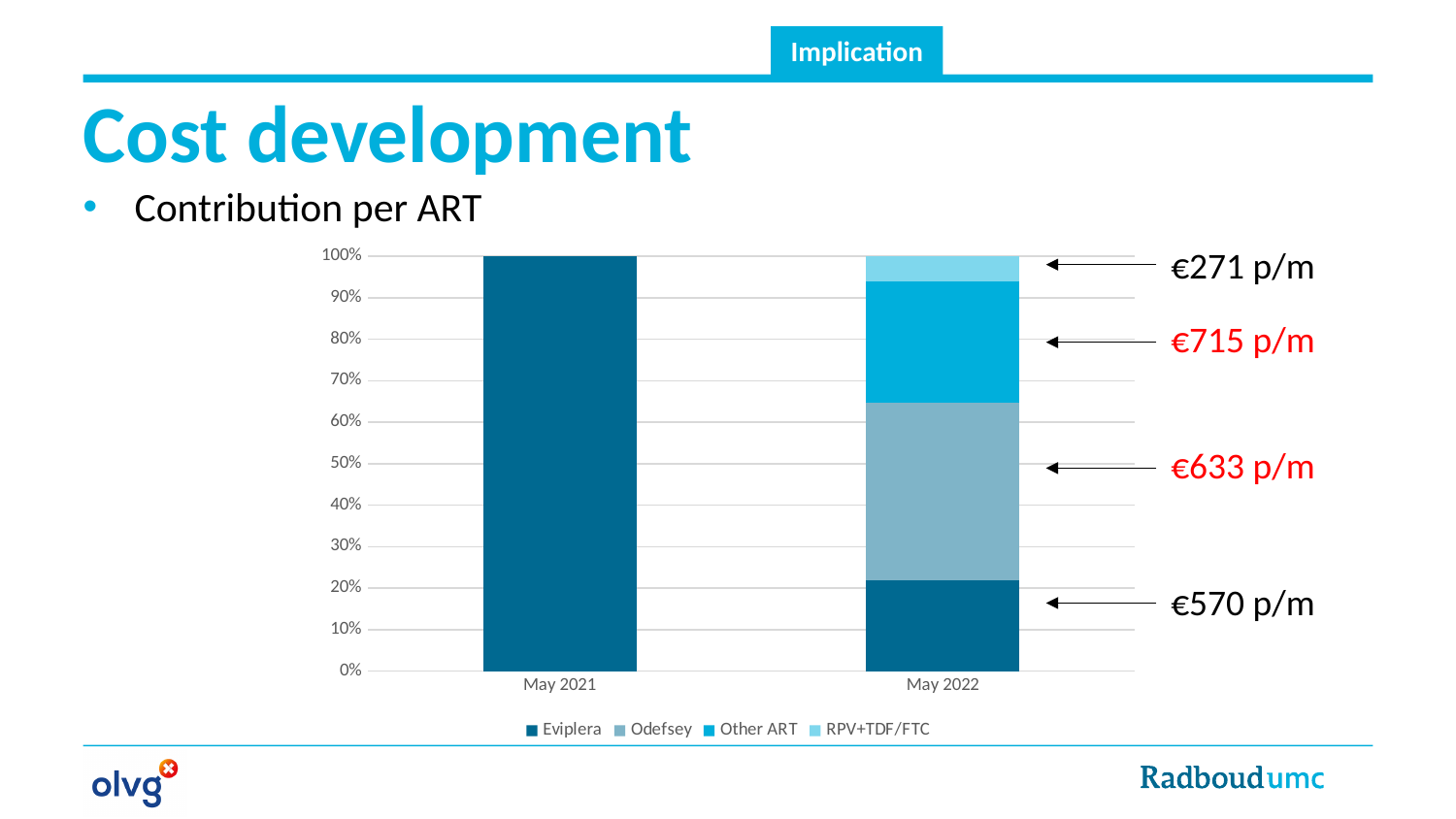
Does the Eviplera share rise or fall from May 2021 to May 2022? fall What monthly cost is annotated next to the Other ART segment of the May 2022 bar? €715 p/m What kind of chart is shown on the slide? Stacked bar chart What monthly cost is annotated next to the Eviplera segment of the May 2022 bar? €570 p/m Is the Eviplera share in the May 2022 bar greater or less than 30%? less Is the RPV+TDF/FTC share in the May 2022 bar greater or less than 10%? less What share of the May 2021 bar is made up by Eviplera? 100% How many series does the chart legend list? 4 In the May 2022 bar, which series has the smallest share? RPV+TDF/FTC In the May 2022 bar, which segment is larger, Odefsey or Eviplera? Odefsey How many categories are shown on the x axis of the chart? 2 In the May 2022 bar, which series has the largest share? Odefsey